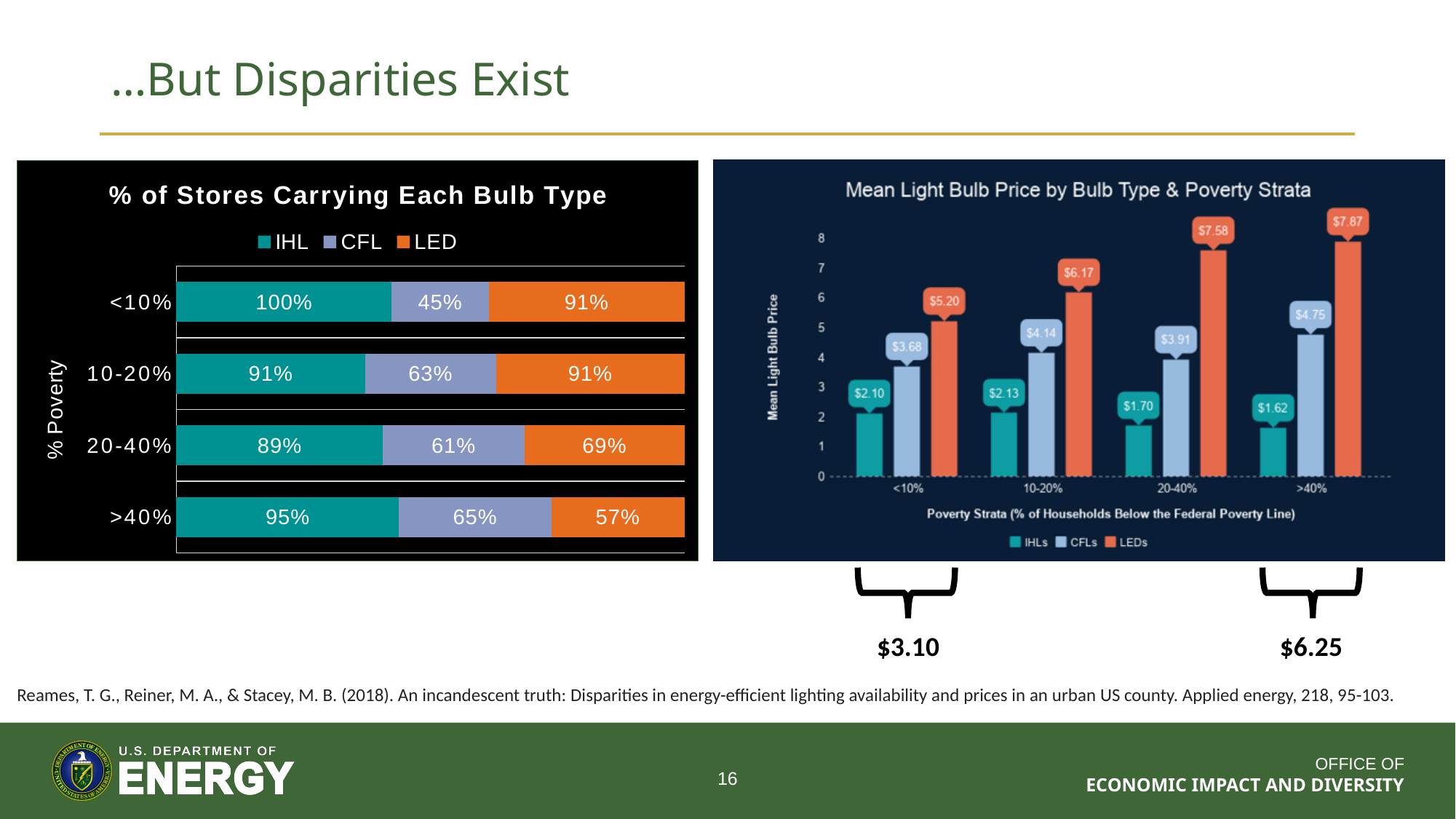
In the '% of Stores Carrying Each Bulb Type' chart, which poverty stratum has the lowest LED value? >40% In the 'Mean Light Bulb Price by Bulb Type & Poverty Strata' chart, what is the mean IHL price for the >40% poverty stratum? $1.62 In the 'Mean Light Bulb Price by Bulb Type & Poverty Strata' chart, how do LED prices change as the poverty stratum increases from <10% to >40%? They rise In the '% of Stores Carrying Each Bulb Type' chart, what is the difference between the IHL and CFL values for the 10-20% stratum? 28% In the 'Mean Light Bulb Price by Bulb Type & Poverty Strata' chart, what is the difference between the LED price and the IHL price in the <10% stratum? $3.10 In the '% of Stores Carrying Each Bulb Type' chart, what is the LED value for the >40% poverty stratum? 57% In the '% of Stores Carrying Each Bulb Type' chart, how many series does the legend list? 3 In the '% of Stores Carrying Each Bulb Type' chart, what percentage of stores in the <10% poverty stratum carry CFL bulbs? 45% In the 'Mean Light Bulb Price by Bulb Type & Poverty Strata' chart, which poverty stratum has the highest LED price? >40% What kind of chart is the 'Mean Light Bulb Price by Bulb Type & Poverty Strata' chart? Bar chart In the 'Mean Light Bulb Price by Bulb Type & Poverty Strata' chart, is the CFL price higher in the 10-20% stratum or the >40% stratum? >40% In the 'Mean Light Bulb Price by Bulb Type & Poverty Strata' chart, what is the mean LED price for the 20-40% poverty stratum? $7.58